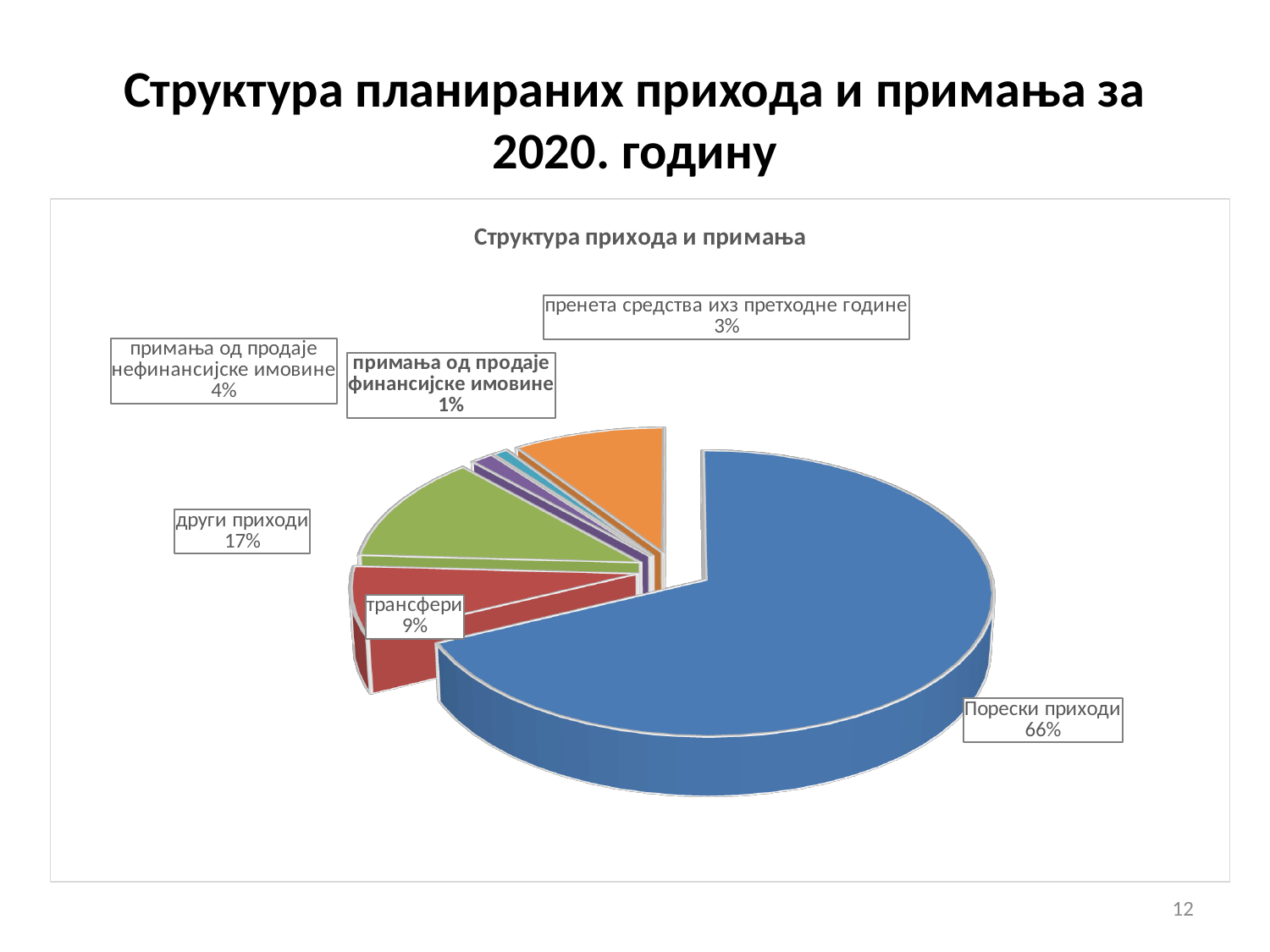
What is the value shown for други приходи? 17% What is the title of the chart? Структура прихода и примања How many slices does the pie chart have? 6 What share of the pie is Порески приходи? 66% What is the difference in percentage points between други приходи and трансфери? 8 What is the value shown for трансфери? 9% What kind of chart is shown on the slide? pie chart Which is larger, the share for трансфери or the share for примања од продаје нефинансијске имовине? трансфери What is the value shown for примања од продаје нефинансијске имовине? 4% Which category has the smallest share of the pie? примања од продаје финансијске имовине Which category has the largest share of the pie? Порески приходи What is the value shown for пренета средства ихз претходне године? 3%